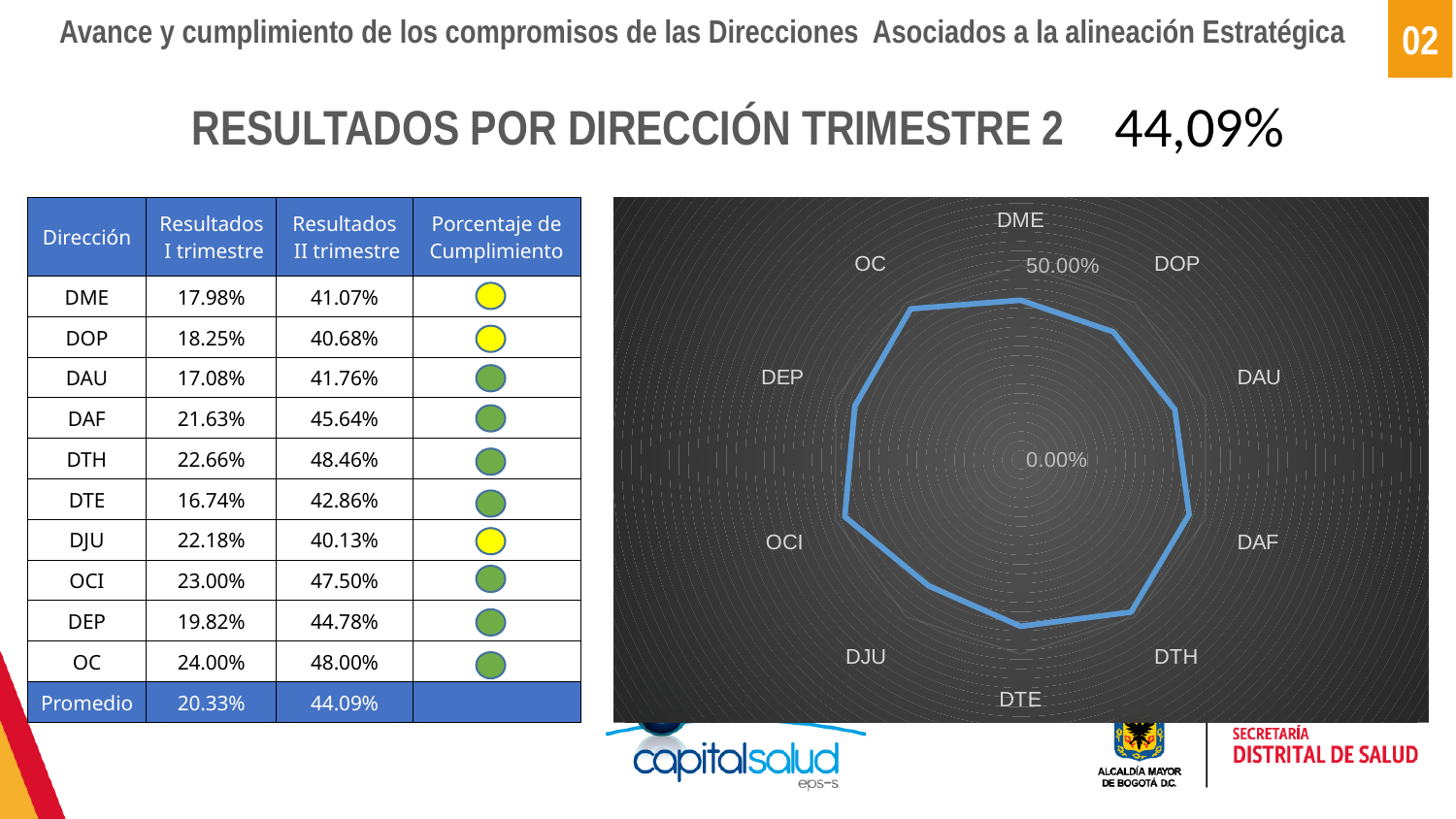
According to the slide, what is the II trimestre result for DTH? 48.46% According to the slide, what is the II trimestre result for DJU? 40.13% What kind of chart is shown on the right side of the slide? radar chart How many categories (direcciones) are plotted on the radar chart? 10 Is the value for DME on the radar chart greater or less than 50.00%? less Which category label appears at the top of the radar chart? DME On the radar chart, which has the larger value, DTH or DJU? DTH What is the highest axis tick value shown on the radar chart? 50.00% Is the value for DJU on the radar chart greater or less than 0.00%? greater On the radar chart, which has the larger value, DAF or DOP? DAF What is the lowest axis tick value shown at the centre of the radar chart? 0.00%